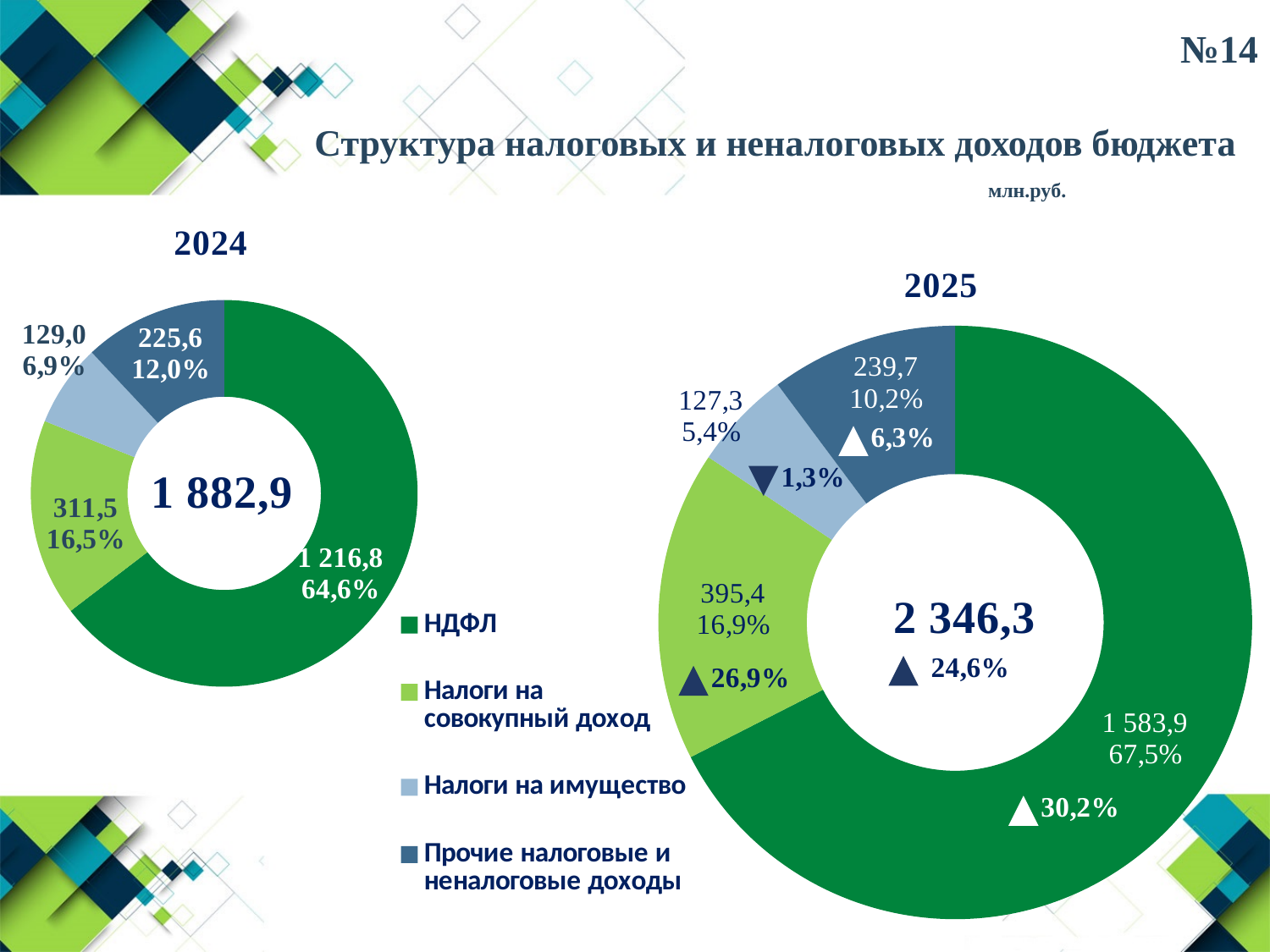
What is the total shown in the centre of the 2025 chart? 2 346,3 On the 2024 chart, which category has the smallest value? Налоги на имущество On the 2024 chart, what share of the total do Прочие налоговые и неналоговые доходы make up? 12,0% How many categories does the legend list? 4 On the 2025 chart, what share of the total does НДФЛ make up? 67,5% What is the total shown in the centre of the 2024 chart? 1 882,9 On the 2025 chart, what is the value for Налоги на имущество? 127,3 What is the difference between the НДФЛ value on the 2025 chart and the НДФЛ value on the 2024 chart? 367,1 What type of chart is used for 2024 and 2025? Doughnut (pie) chart On the 2024 chart, what is the value for НДФЛ? 1 216,8 On the 2025 chart, which is larger: Налоги на совокупный доход or Прочие налоговые и неналоговые доходы? Налоги на совокупный доход On the 2025 chart, which category has the largest value? НДФЛ